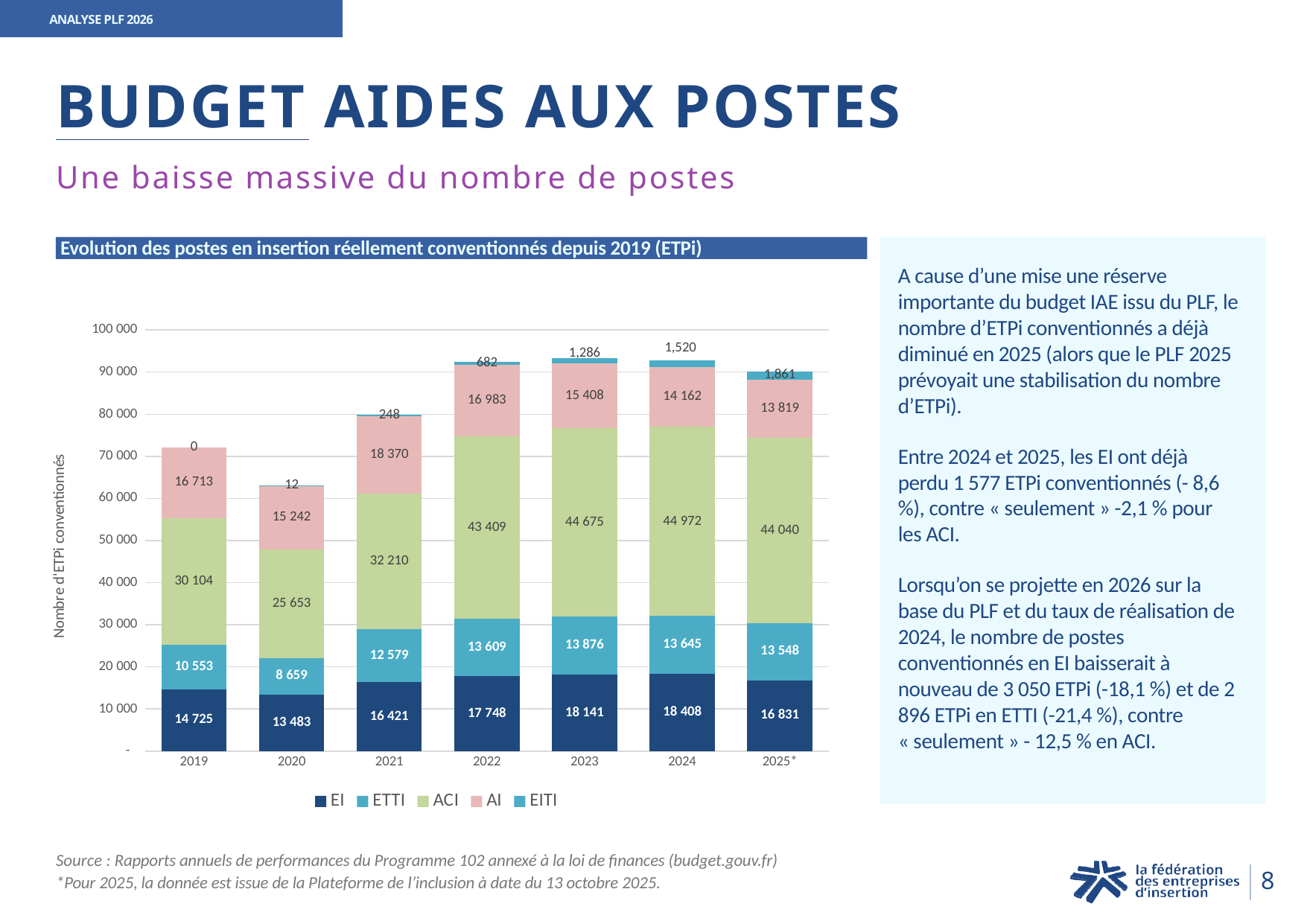
Is the total of the 2020 bar greater or less than 70 000? less What is the value for EI in 2019? 14 725 What is the total of the stacked bar for 2019? 72 095 In which year is the EI value highest? 2024 What is the value for EITI in 2024? 1,520 In which year is the ACI value lowest? 2020 Which is larger, the AI value in 2021 or the AI value in 2022? 2021 What is the value for ACI in 2022? 43 409 How many years are shown on the x axis? 7 How many series does the legend list? 5 What type of chart is shown on the slide? Stacked bar chart What is the difference between the EI value in 2024 and in 2025*? 1 577